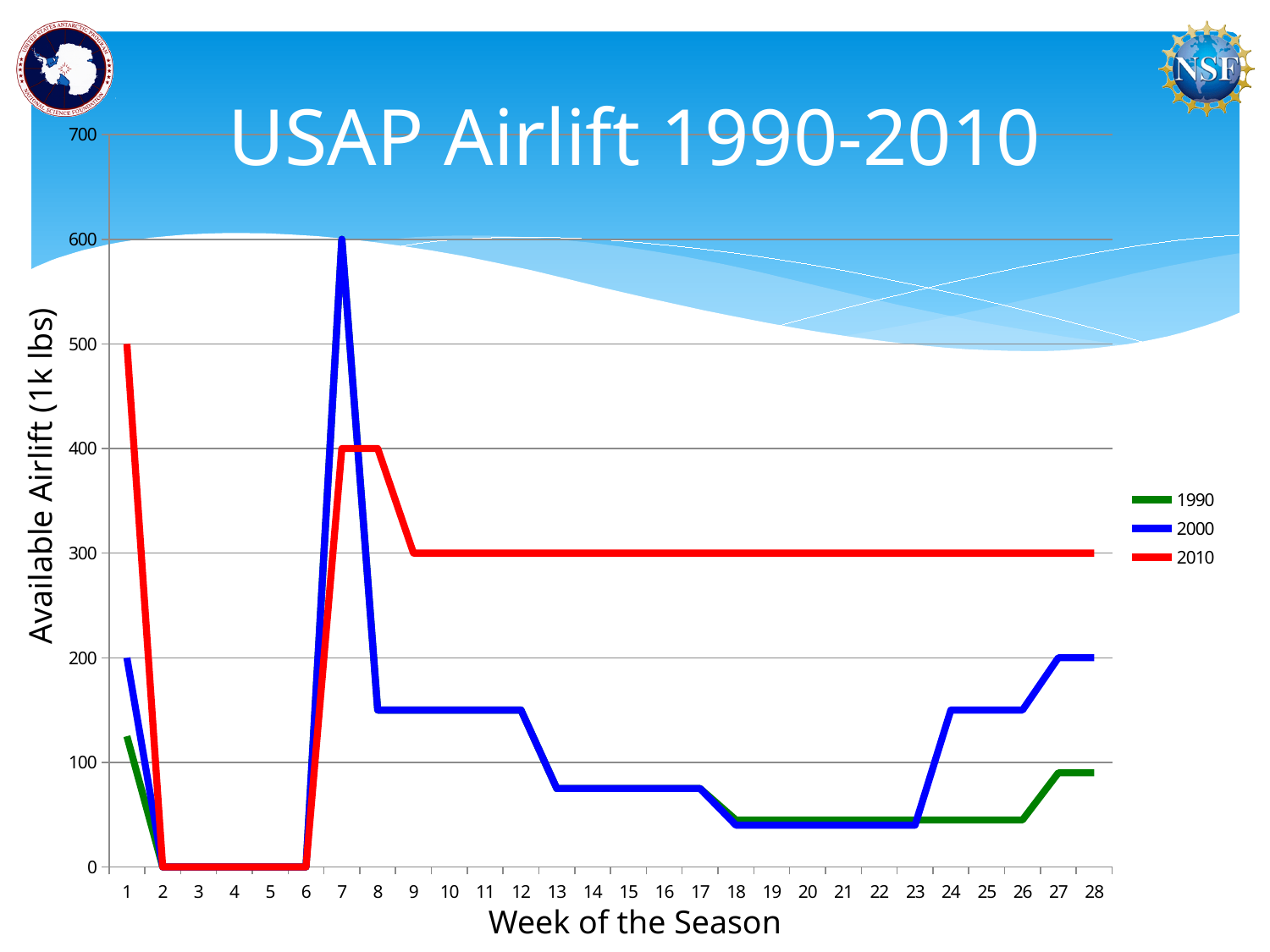
Which series has the highest value at week 15? 2010 How many weeks are shown on the x axis? 28 Is the value for the 2000 series at week 10 greater or less than 200? less Which is larger at week 1: the value for 2000 or the value for 2010? 2010 What is the value for the 2010 series at week 20? 300 What type of chart is shown on the slide? line chart What is the value for the 2010 series at week 1? 500 How many series does the legend list? 3 What is the difference between the 2010 value at week 7 and the 2010 value at week 9? 100 Is the value for the 1990 series at week 27 greater or less than 100? less What is the value for the 2000 series at week 7? 600 What is the value for the 2000 series at week 28? 200